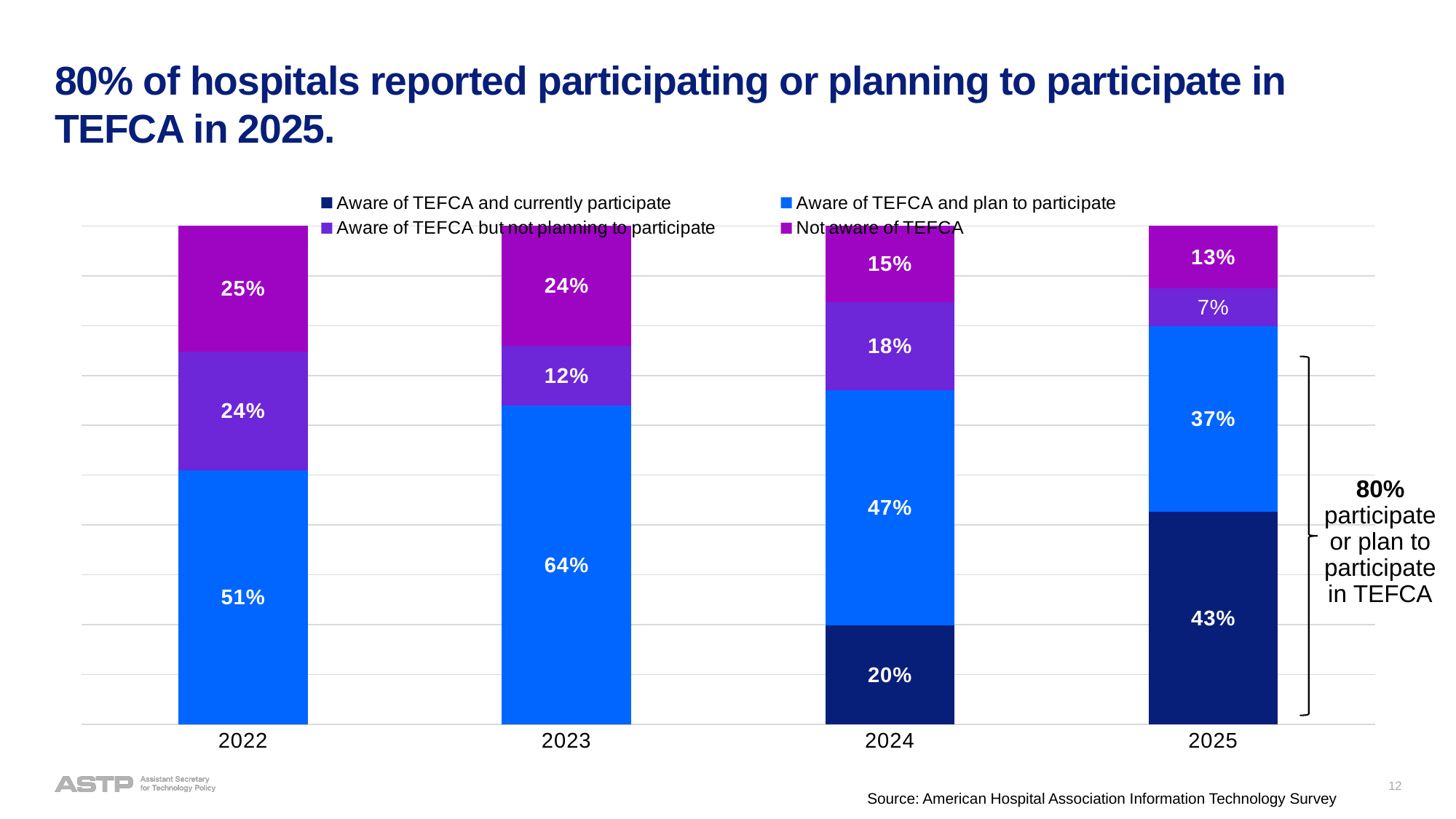
What percentage of hospitals were aware of TEFCA but not planning to participate in 2024? 18% How many series does the legend list? 4 What kind of chart is shown on the slide? stacked bar chart Which is larger in 2025: the share that currently participate or the share that plan to participate? currently participate (43%) In which year was the 'Not aware of TEFCA' share the lowest? 2025 Does the 'Not aware of TEFCA' share rise or fall from 2022 to 2025? fall What percentage of hospitals were aware of TEFCA and plan to participate in 2023? 64% What is the difference between the 'Aware of TEFCA and currently participate' share in 2025 and in 2024? 23 percentage points In which year was the 'Aware of TEFCA and plan to participate' share the highest? 2023 What percentage of hospitals were not aware of TEFCA in 2022? 25% How many years are shown on the x axis? 4 What percentage of hospitals were aware of TEFCA and currently participate in 2025? 43%